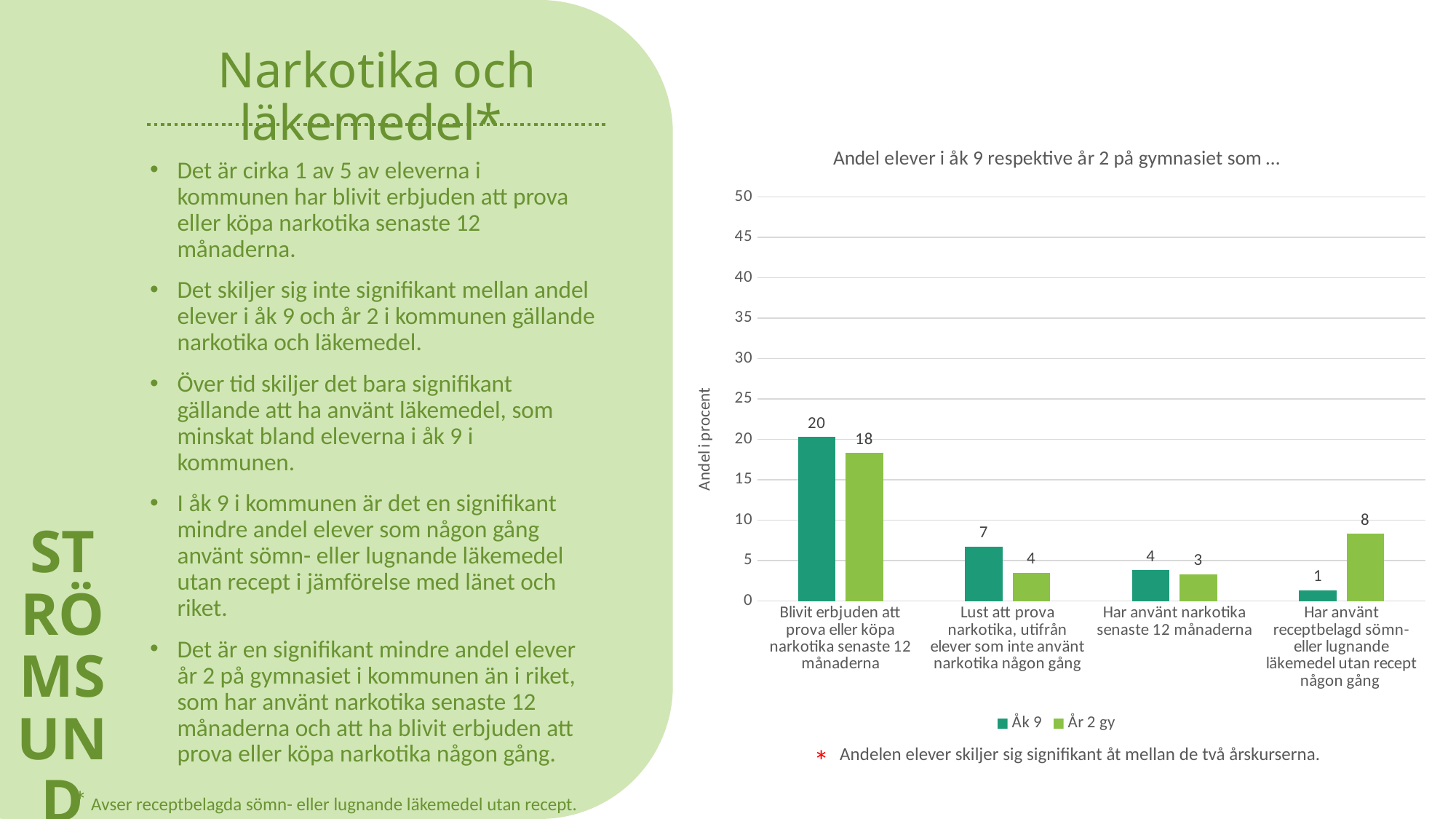
What is the value for Åk 9 in the category "Blivit erbjuden att prova eller köpa narkotika senaste 12 månaderna"? 20 Which category has the highest value for År 2 gy? Blivit erbjuden att prova eller köpa narkotika senaste 12 månaderna How many categories are shown on the x axis of the chart? 4 Is the value for Åk 9 in "Blivit erbjuden att prova eller köpa narkotika senaste 12 månaderna" greater or less than 15? greater Which is larger in the category "Lust att prova narkotika, utifrån elever som inte använt narkotika någon gång": Åk 9 or År 2 gy? Åk 9 What is the value for Åk 9 in the category "Lust att prova narkotika, utifrån elever som inte använt narkotika någon gång"? 7 What is the label of the vertical axis of the chart? Andel i procent How many series does the chart legend list? 2 What is the value for År 2 gy in the category "Har använt receptbelagd sömn- eller lugnande läkemedel utan recept någon gång"? 8 What is the difference between Åk 9 and År 2 gy in the category "Har använt receptbelagd sömn- eller lugnande läkemedel utan recept någon gång"? 7 Which category has the lowest value for Åk 9? Har använt receptbelagd sömn- eller lugnande läkemedel utan recept någon gång What type of chart is shown on the slide? bar chart